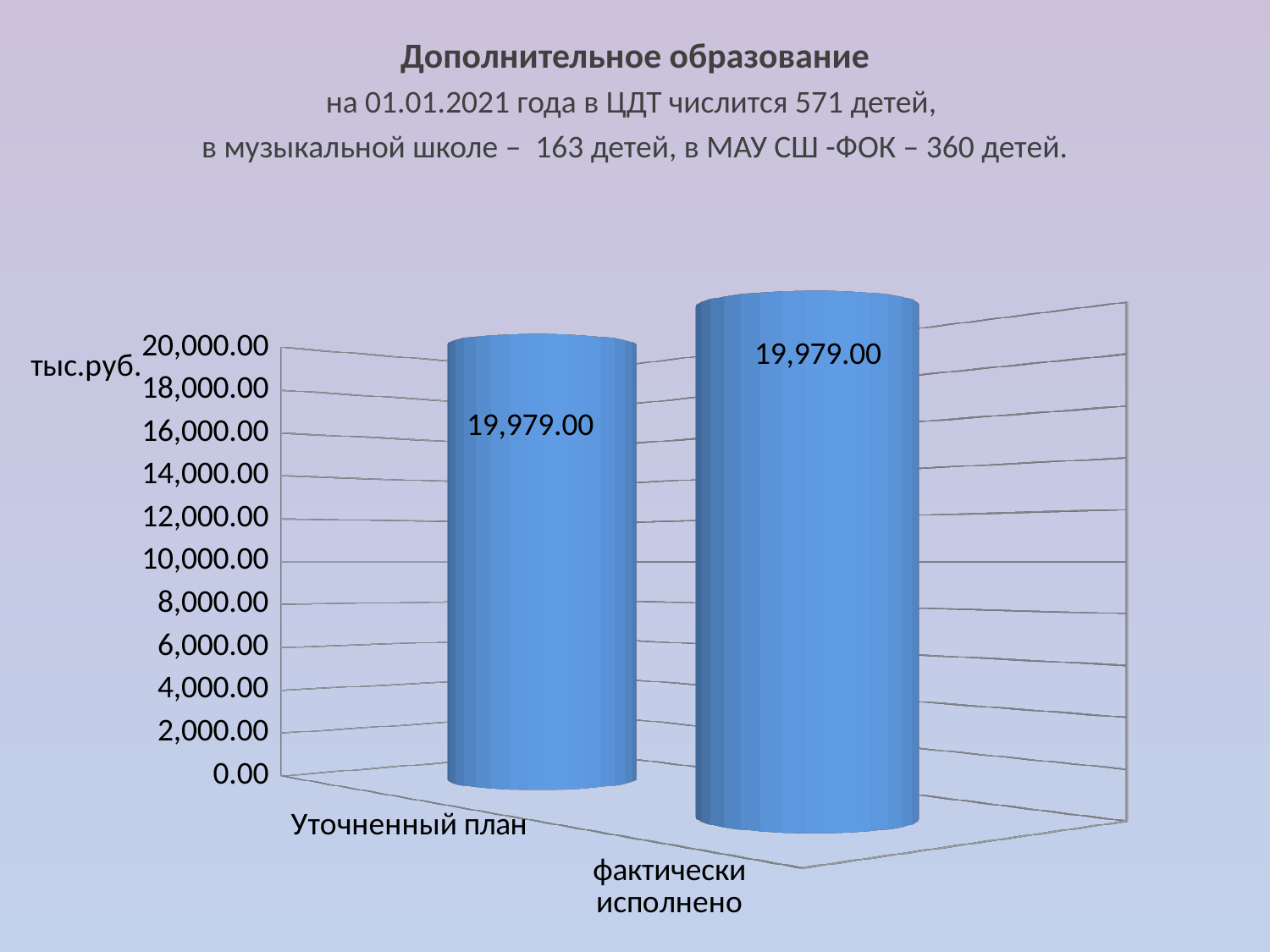
What kind of chart is shown on the slide? bar chart What is the title at the top of the slide? Дополнительное образование What is the difference between the value for Уточненный план and the value for фактически исполнено? 0.00 Is the value for Уточненный план greater or less than 18,000.00? greater Is the value for фактически исполнено greater or less than 10,000.00? greater What unit label is shown next to the vertical axis of the chart? тыс.руб. What is the value for фактически исполнено? 19,979.00 How many categories are shown on the chart? 2 Is the value for фактически исполнено larger than, smaller than, or equal to the value for Уточненный план? equal What is the value for Уточненный план? 19,979.00